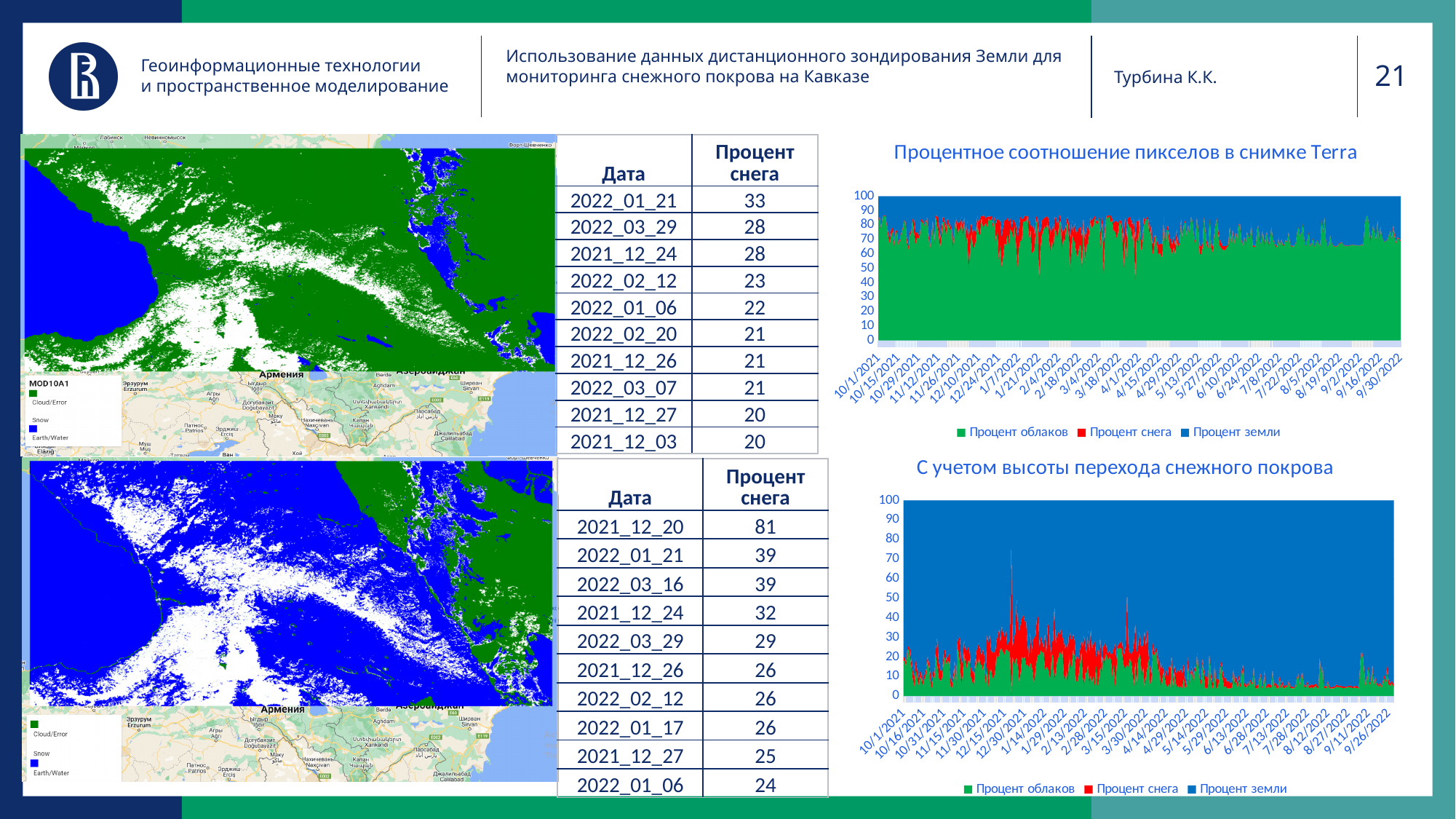
In the bottom chart 'С учетом высоты перехода снежного покрова', does the snow percent rise or fall from March 2022 to August 2022? fall What kind of chart is the bottom chart titled 'С учетом высоты перехода снежного покрова'? Stacked area chart How many series does the legend of the bottom chart 'С учетом высоты перехода снежного покрова' list? 3 How many series does the legend of the top chart 'Процентное соотношение пикселов в снимке Terra' list? 3 In the top chart 'Процентное соотношение пикселов в снимке Terra', is the earth percent (blue) at the start of the period greater or less than 50? less What kind of chart is the top chart titled 'Процентное соотношение пикселов в снимке Terra'? Stacked area chart In the top chart 'Процентное соотношение пикселов в снимке Terra', which series is shown in red? Процент снега What is the title of the bottom chart on the slide? С учетом высоты перехода снежного покрова